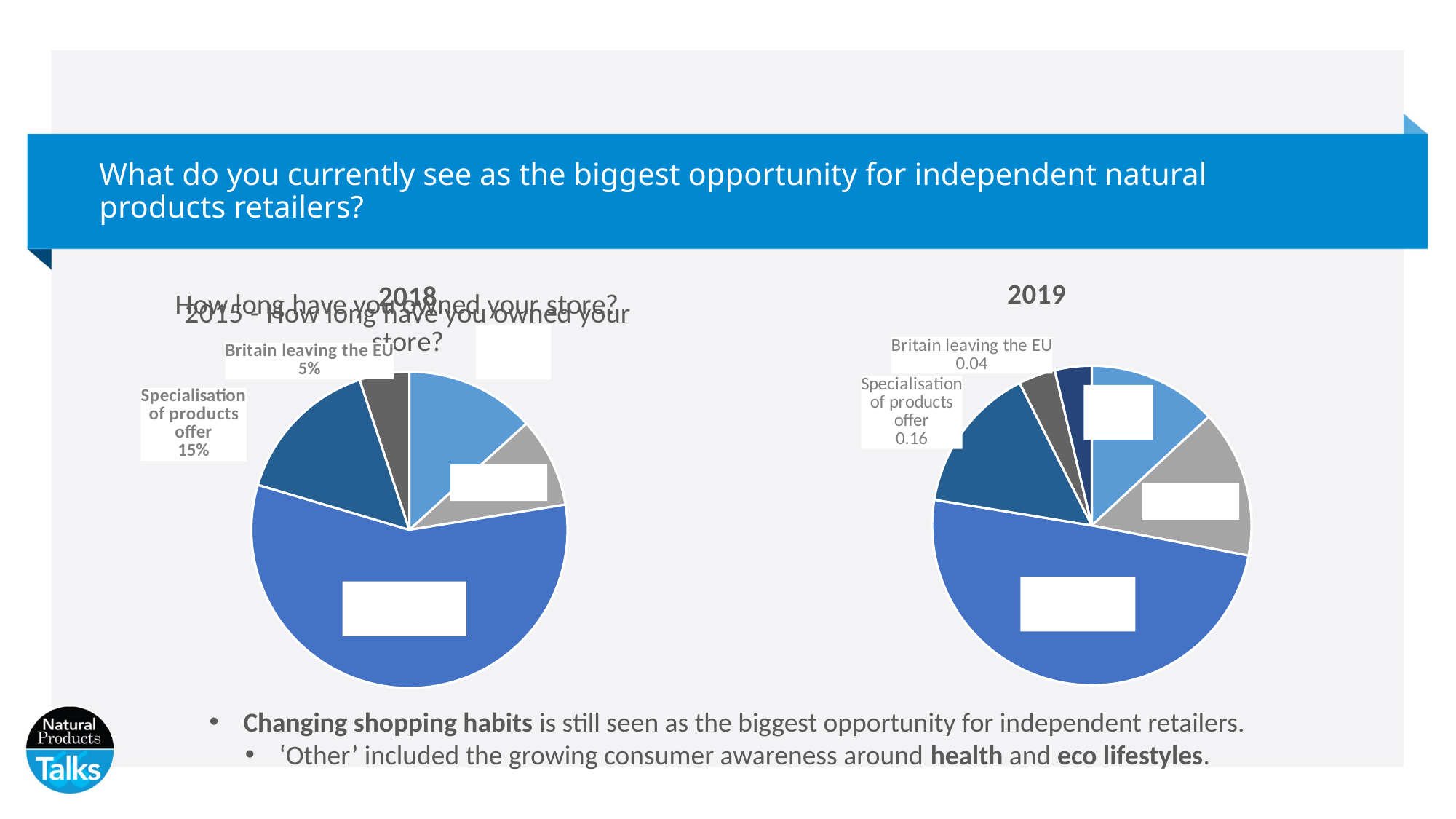
In the 2019 pie chart, what is the difference between the values for Specialisation of products offer and Britain leaving the EU? 0.12 In the 2018 pie chart, which is larger: Britain leaving the EU or Specialisation of products offer? Specialisation of products offer In the 2018 pie chart, what is the difference between the shares for Specialisation of products offer and Britain leaving the EU? 10% How many slices does the 2019 pie chart have? 6 In the 2019 pie chart, what value is shown for Britain leaving the EU? 0.04 In the 2019 pie chart, what value is shown for Specialisation of products offer? 0.16 How many slices does the 2018 pie chart have? 5 What is the title of the pie chart on the right of the slide? 2019 In the 2018 pie chart, what share is shown for Specialisation of products offer? 15% In the 2019 pie chart, which is larger: Britain leaving the EU or Specialisation of products offer? Specialisation of products offer In the 2018 pie chart, what share is shown for Britain leaving the EU? 5% What kind of chart is the 2019 chart? Pie chart